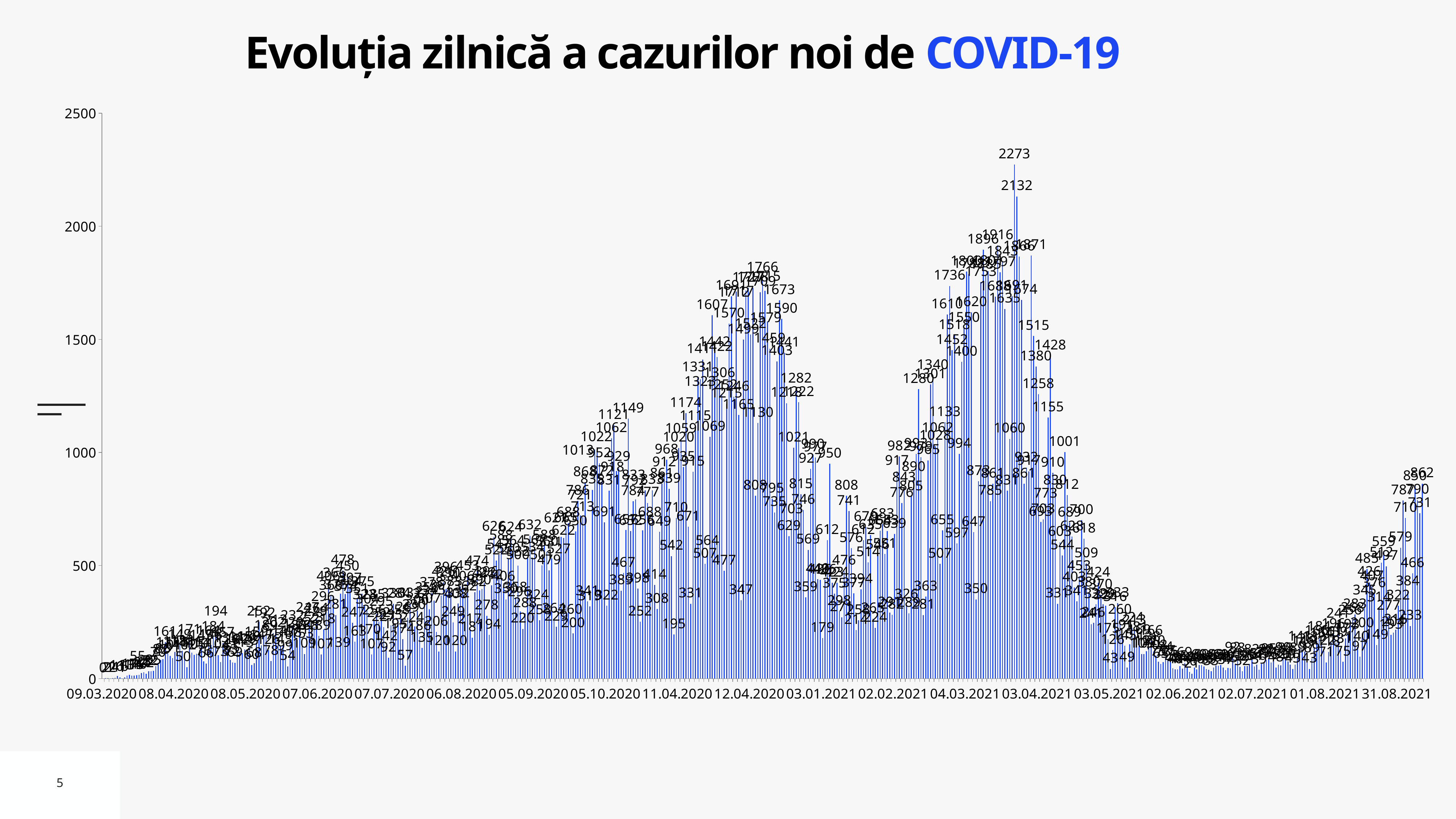
What is the highest daily value labelled on the chart? 2273 Is the highest bar on the chart greater or less than 2500? less Is the highest bar on the chart greater or less than 2000? greater Which is larger: the peak labelled 2273 or the peak labelled 1766? 2273 What is the title of the chart? Evoluția zilnică a cazurilor noi de COVID-19 What is the first date label on the x axis? 09.03.2020 What is the difference between the two highest labelled values, 2273 and 2132? 141 Do the values rise or fall along the x axis between 02.06.2021 and 31.08.2021? rise What is the second-highest daily value labelled on the chart, next to the 2273 peak? 2132 What kind of chart is shown on the slide? bar chart Do the values rise or fall along the x axis between 03.04.2021 and 03.05.2021? fall